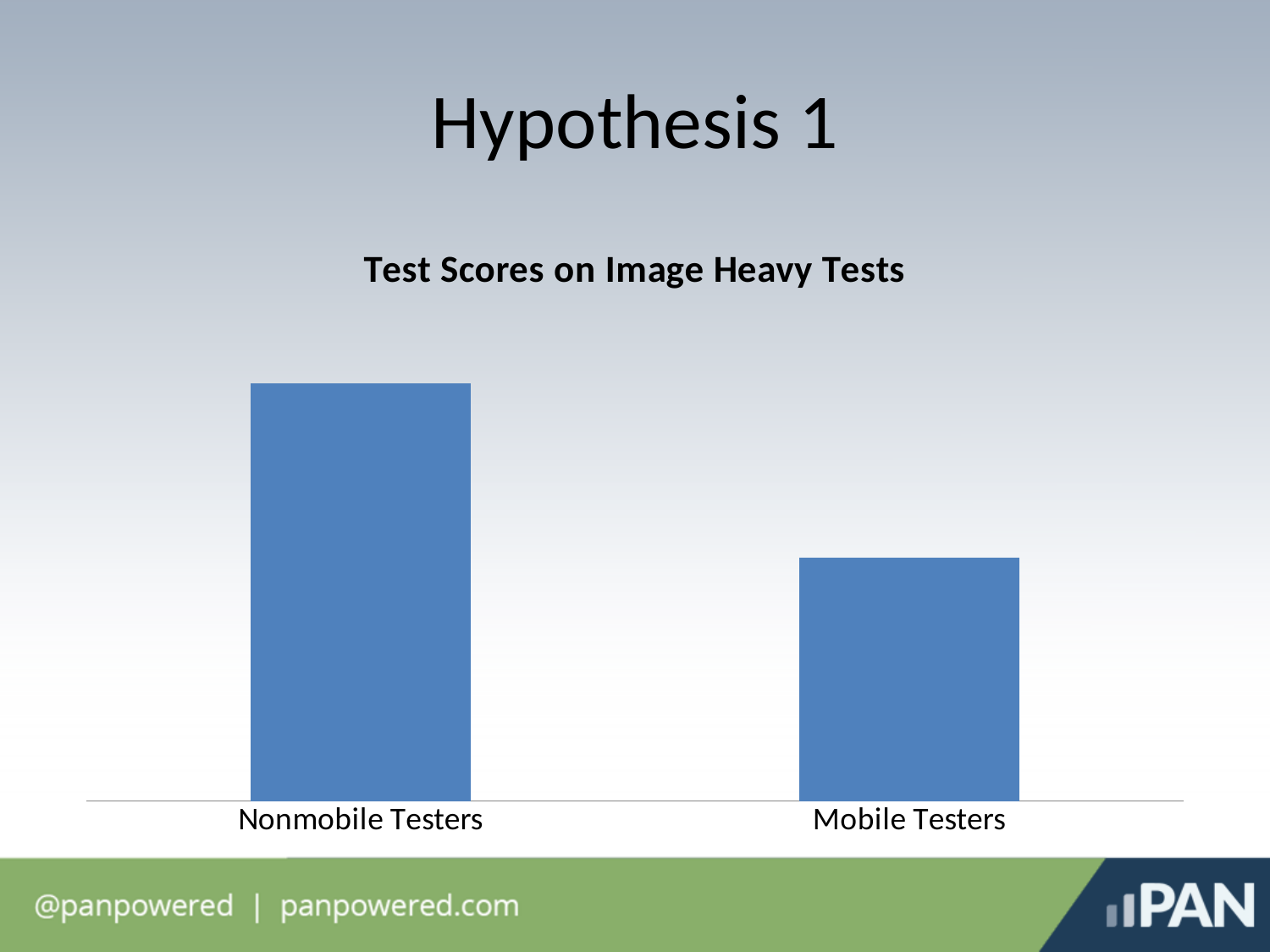
What is the label of the left-hand category on the x axis? Nonmobile Testers What kind of chart is shown on the slide? bar chart What is the title of the chart? Test Scores on Image Heavy Tests How many categories are shown in the chart? 2 Which is larger, the bar for Nonmobile Testers or the bar for Mobile Testers? Nonmobile Testers Which category has the lowest bar? Mobile Testers Which category has the highest bar? Nonmobile Testers Do the bars rise or fall from left to right along the x axis? fall